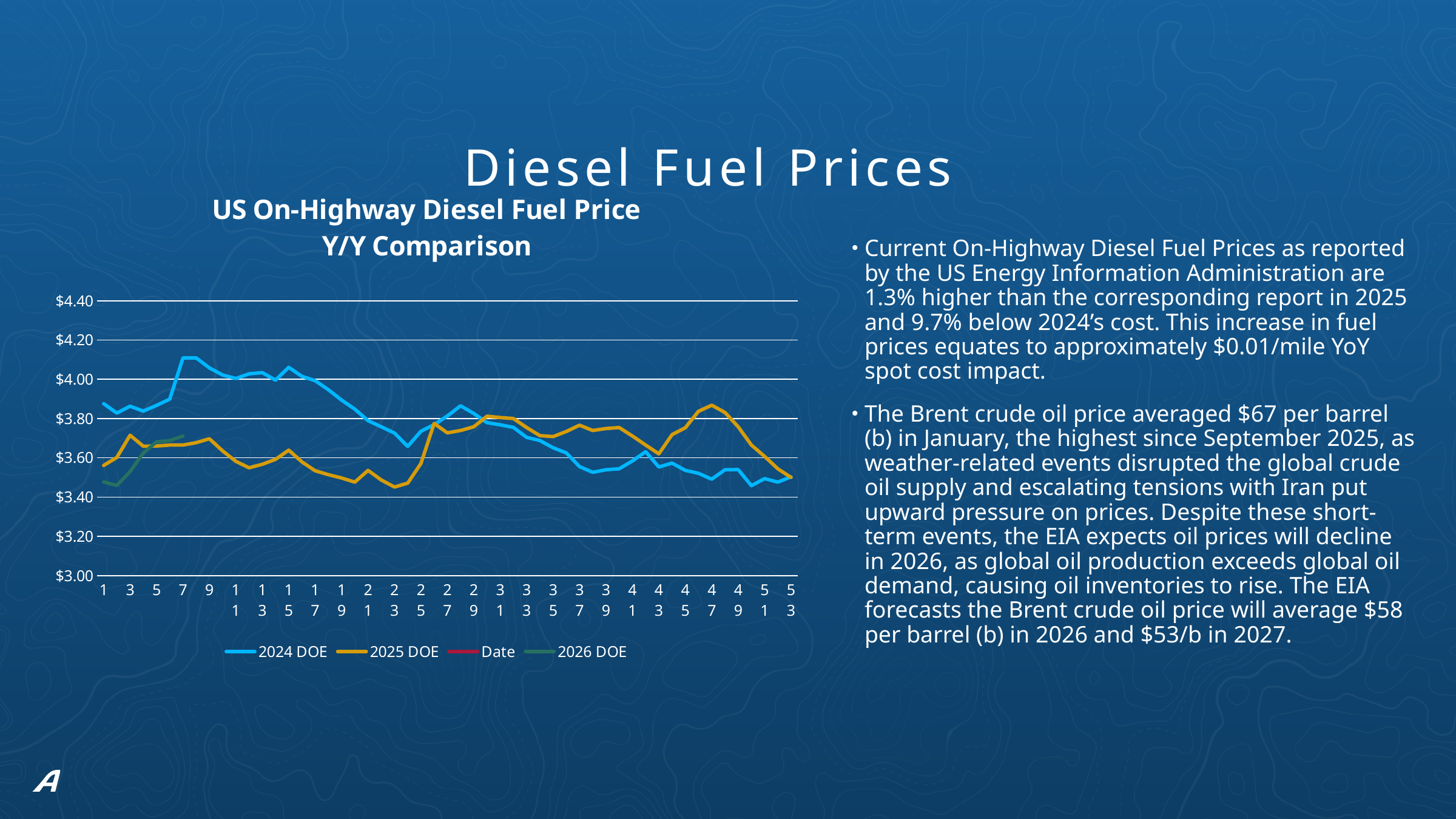
At week 47, which series has the higher value, 2024 DOE or 2025 DOE? 2025 DOE Is the 2024 DOE value at week 7 greater or less than $4.00? greater How many series does the chart legend list? 4 Is the 2026 DOE value at week 1 greater or less than $3.60? less What is the title of the chart? US On-Highway Diesel Fuel Price Y/Y Comparison What is the highest value shown on the chart's y axis? $4.40 Is the 2025 DOE value at week 47 greater or less than $3.80? greater What kind of chart is shown on the slide? Line chart Does the 2024 DOE line rise or fall between week 7 and week 23? Fall At week 7, which series has the higher value, 2024 DOE or 2025 DOE? 2024 DOE